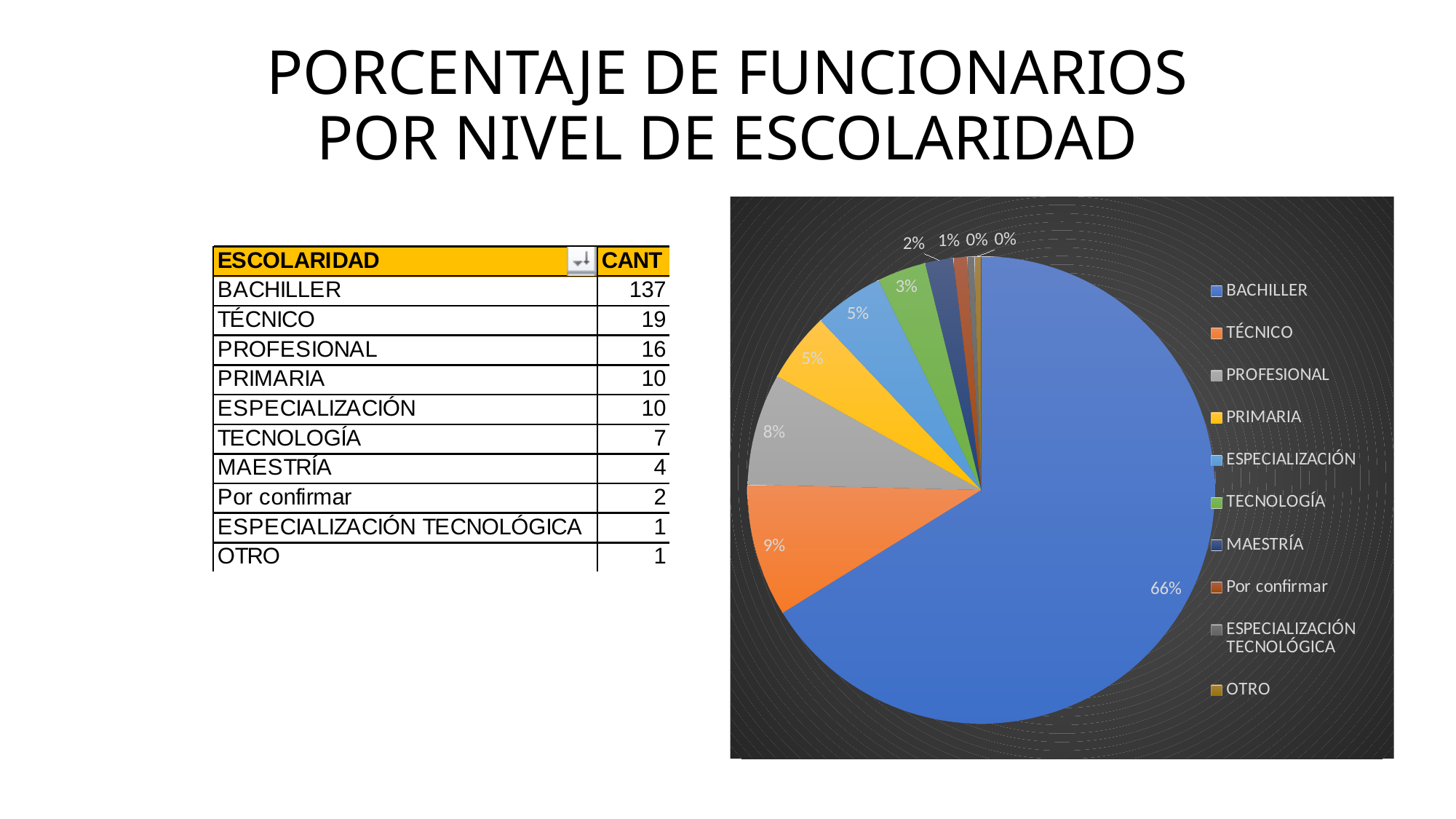
What share of the pie does PROFESIONAL take? 8% What share of the pie does MAESTRÍA take? 2% What share of the pie does TÉCNICO take? 9% Which slice is larger, BACHILLER or TÉCNICO? BACHILLER How many categories does the pie chart's legend list? 10 What is the difference in percentage points between the BACHILLER slice and the TÉCNICO slice? 57 What colour is the BACHILLER slice in the pie chart? Blue Which slice is larger, TÉCNICO or PROFESIONAL? TÉCNICO What kind of chart is shown on the slide? Pie chart Which category has the largest slice of the pie? BACHILLER